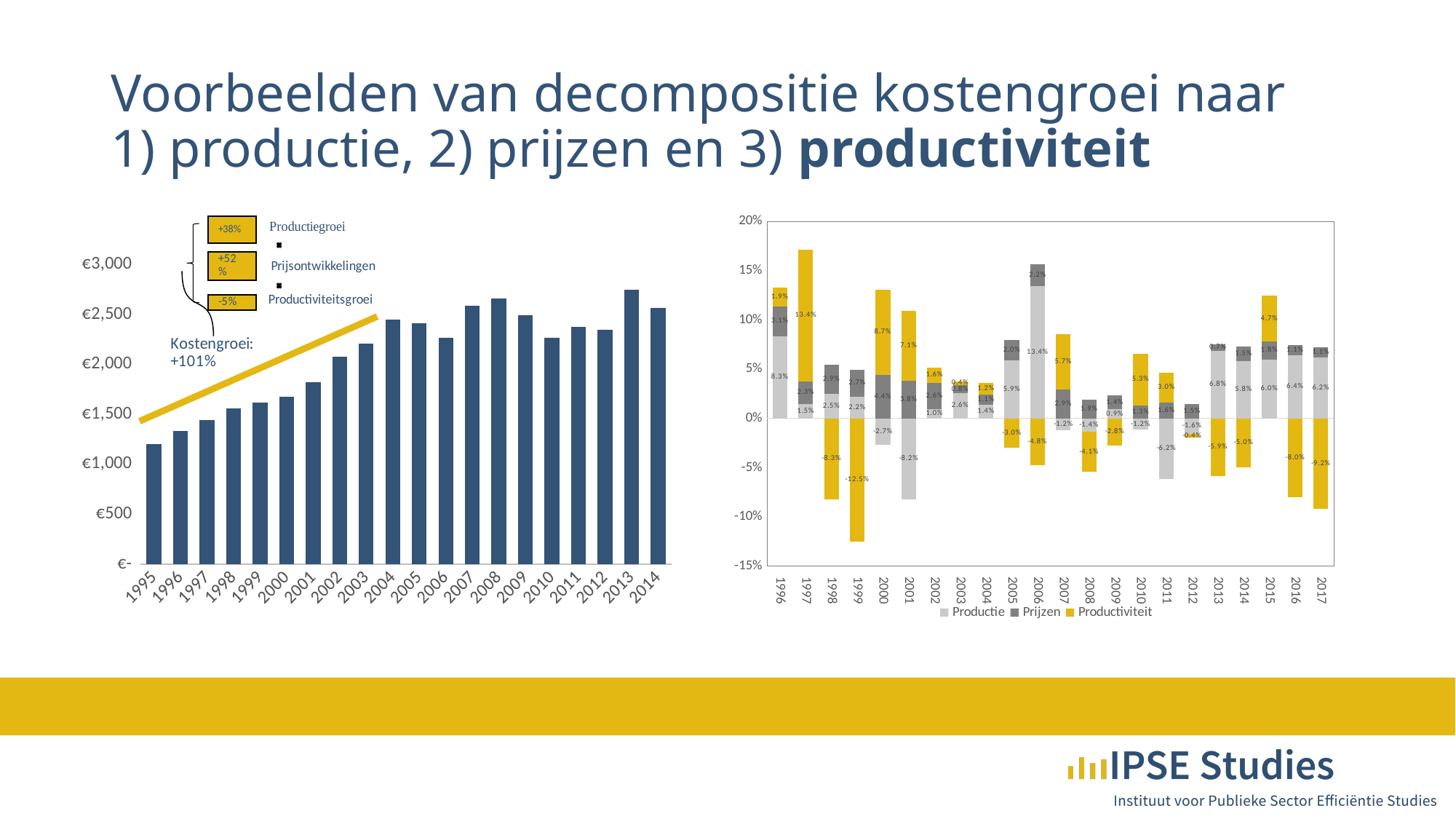
On the left chart, is the value for 2013 greater or less than €2,500? greater On the right chart, what is the Productiviteit value for 1999? -12.5% On the left chart, is the value for 1995 greater or less than €1,500? less On the right chart, how many series does the legend list? 3 On the right chart, which year has the lowest Productiviteit value? 1999 On the left chart, how many years are shown on the x axis? 20 On the left chart, which year has the lowest bar? 1995 On the right chart, what is the Productie value for 1996? 8.3% On the right chart, which is larger: the Productiviteit value for 1997 or for 2000? 1997 What kind of chart is the chart on the left? bar chart On the right chart, what is the Productiviteit value for 1997? 13.4% On the left chart, which year has the highest bar? 2013